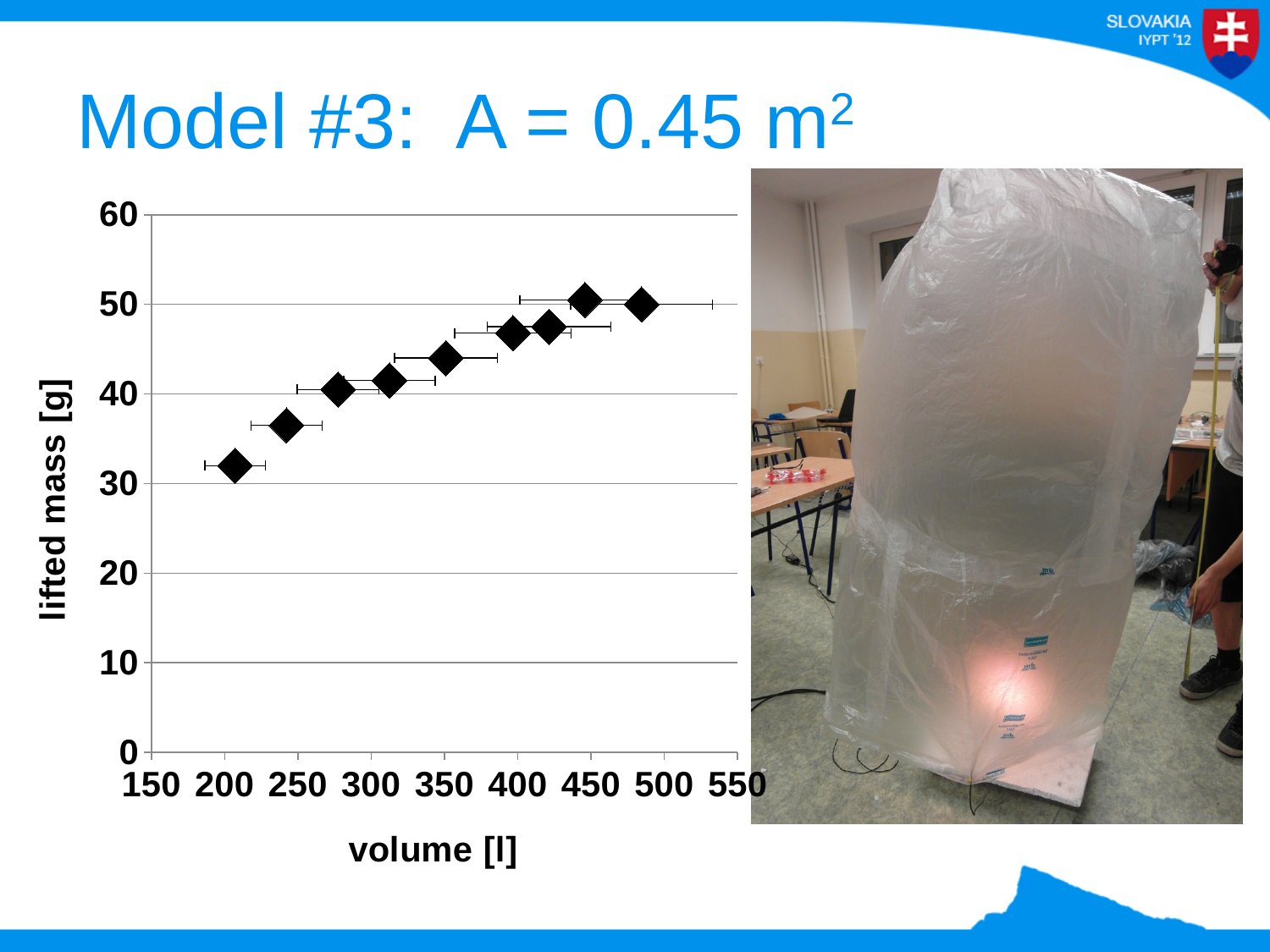
How many data points are plotted in the chart? 9 Is the lifted mass of the rightmost data point greater or less than 40 g? greater Is the lifted mass of the highest data point greater or less than 60 g? less Is the lifted mass of the leftmost data point greater or less than 30 g? greater What is the label of the y axis? lifted mass [g] Which has the larger lifted mass: the leftmost data point or the rightmost data point? the rightmost data point What is the maximum value shown on the y axis? 60 What is the minimum value shown on the x axis? 150 Does the lifted mass rise or fall as the volume increases along the x axis? rise What is the label of the x axis? volume [l] What kind of chart is shown on the slide? scatter chart